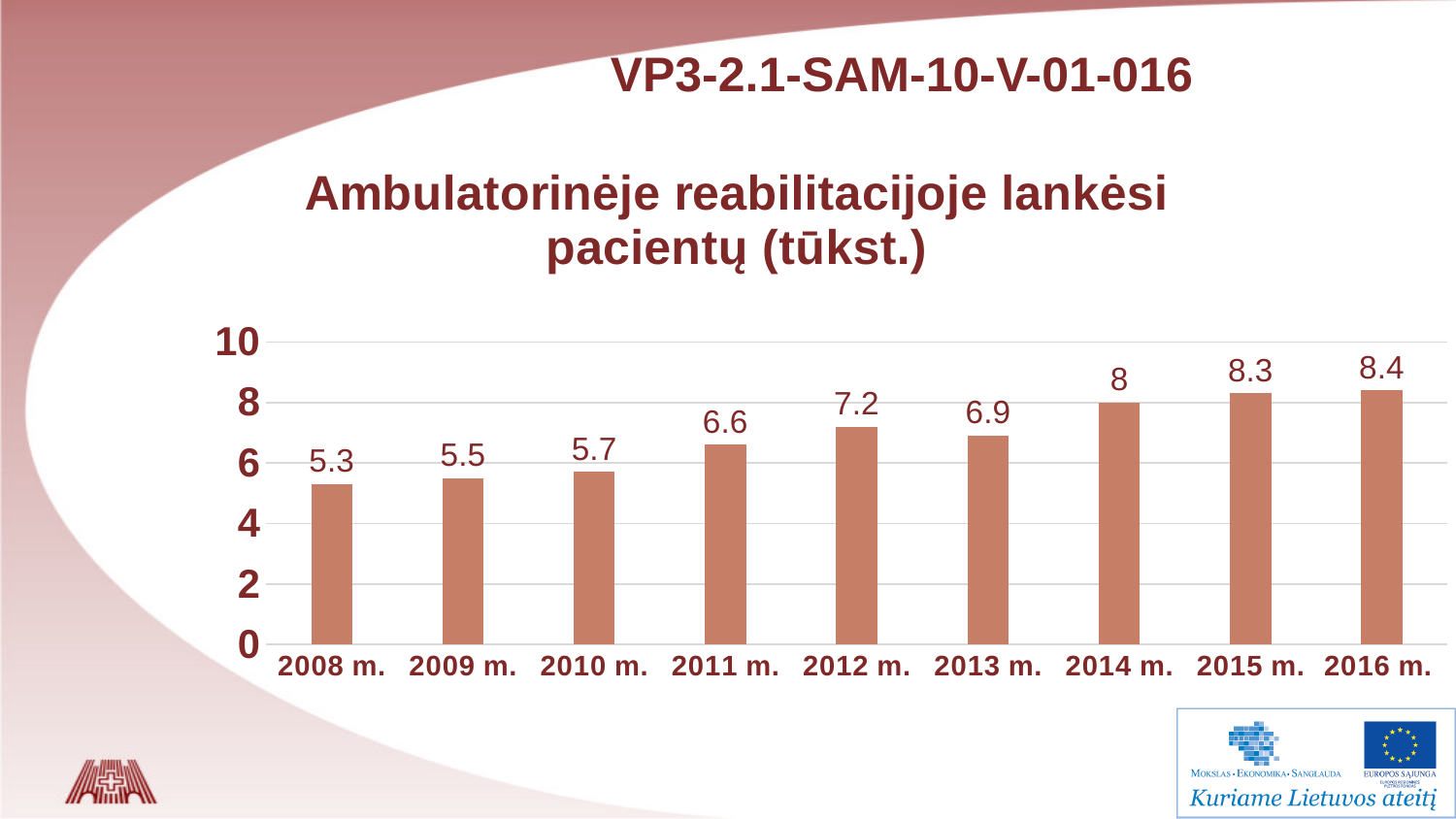
What is the value for 2012 m.? 7.2 Which year has the highest value? 2016 m. What is the value for 2008 m.? 5.3 Is the value for 2015 m. greater or less than 8? greater What is the difference between the values for 2016 m. and 2008 m.? 3.1 Which year has the lowest value? 2008 m. What is the value for 2014 m.? 8 What is the title of the chart? Ambulatorinėje reabilitacijoje lankėsi pacientų (tūkst.) Which is larger, the value for 2011 m. or the value for 2013 m.? 2013 m. What is the difference between the values for 2012 m. and 2013 m.? 0.3 What kind of chart is shown on the slide? bar chart How many years are shown on the x axis? 9